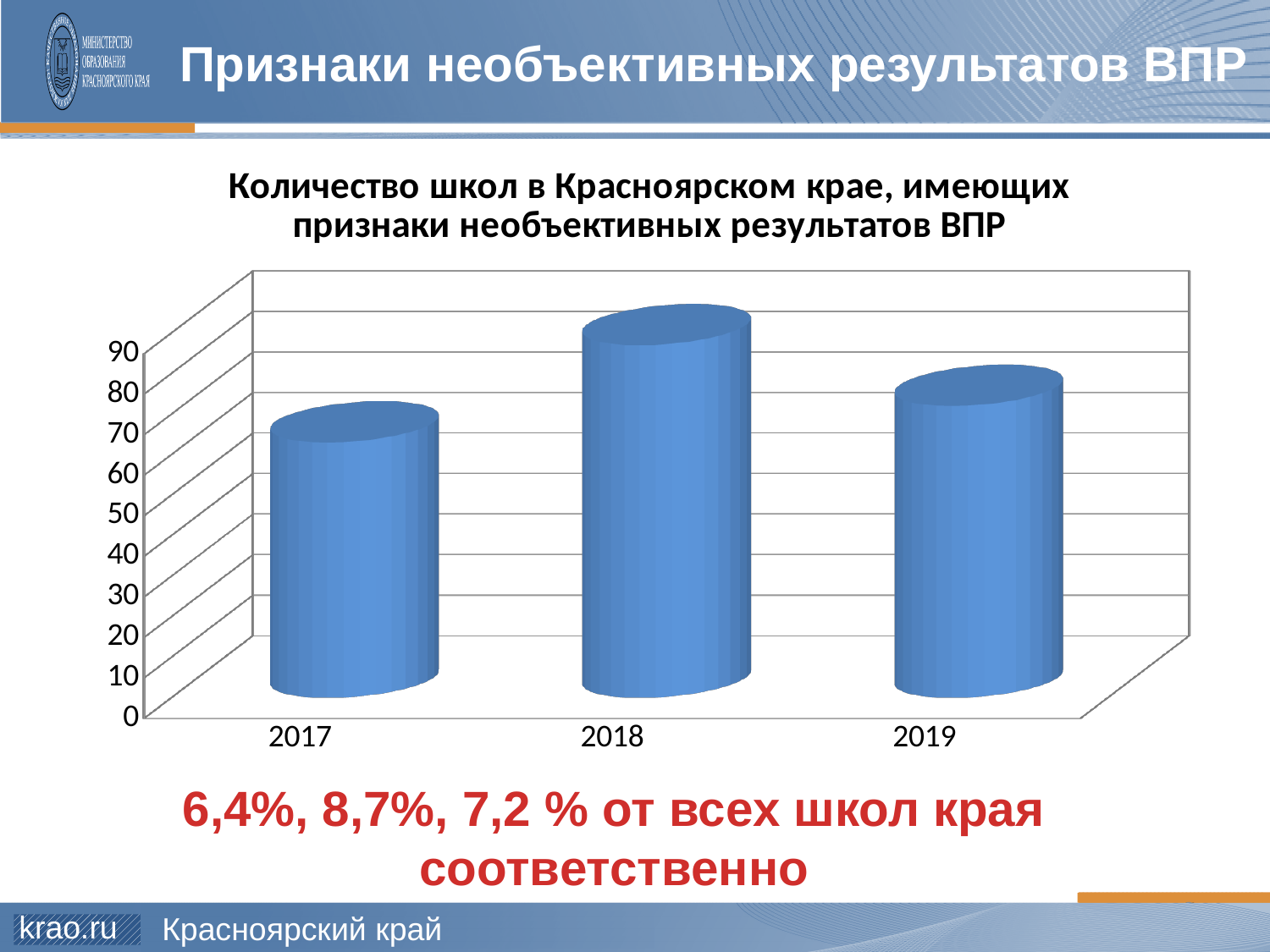
Which year has the lowest number of schools with signs of non-objective VPR results? 2017 Do the values rise or fall from 2018 to 2019? fall Is the value for 2018 greater or less than 70? greater Is the value for 2017 greater or less than 80? less What kind of chart is shown on the slide? bar chart Is the value for 2017 greater or less than 50? greater Which year has the highest number of schools with signs of non-objective VPR results? 2018 How many years are shown on the x axis of the chart? 3 Which year has the larger value, 2017 or 2019? 2019 What is the title of the chart? Количество школ в Красноярском крае, имеющих признаки необъективных результатов ВПР Which year has the larger value, 2018 or 2019? 2018